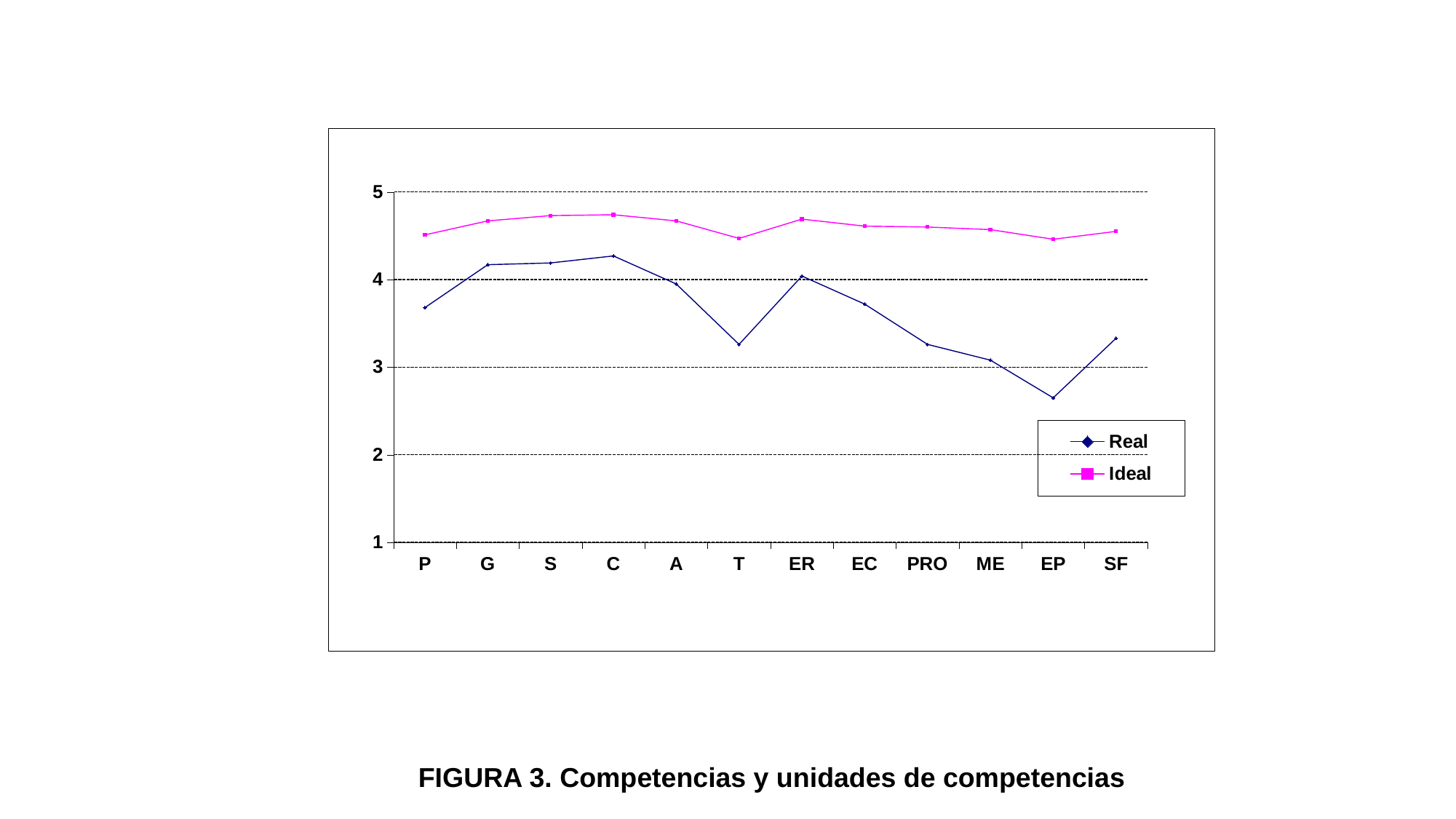
For the Real series, which is larger, the value for G or the value for T? G Does the Real series rise or fall from ER to EP? fall Is the Ideal value for P greater or less than 4? greater Is the Real value for EP greater or less than 3? less What kind of chart is shown on the slide? line chart Which category has the lowest value for the Real series? EP Is the Real value for EC greater or less than 4? less How many categories are shown on the x axis? 12 How many series does the legend list? 2 At category T, which series has the larger value, Real or Ideal? Ideal What is the caption shown below the chart? FIGURA 3. Competencias y unidades de competencias